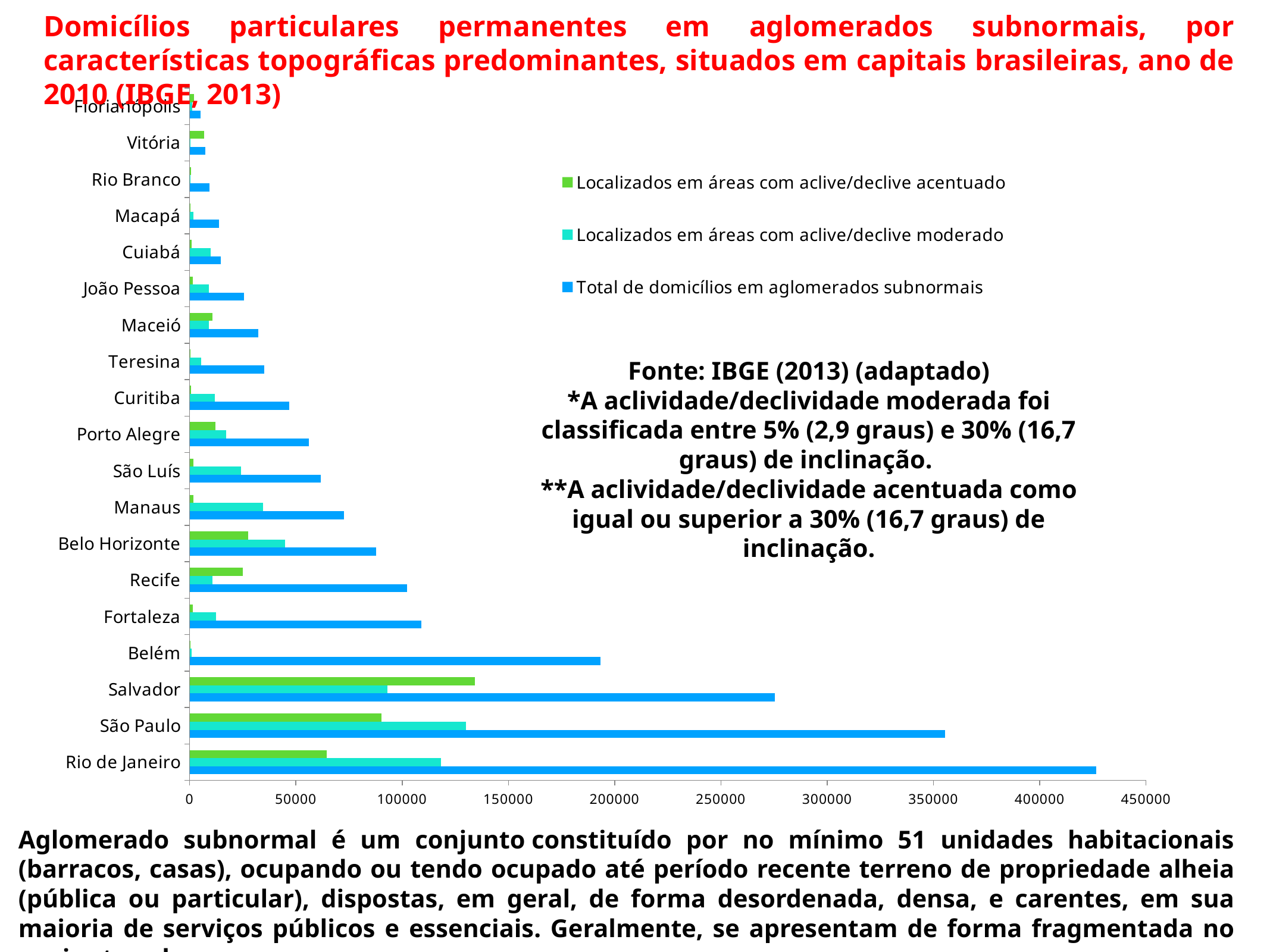
Is the value for Salvador in 'Total de domicílios em aglomerados subnormais' greater or less than 300000? less Which is larger: the 'Localizados em áreas com aclive/declive moderado' value for São Paulo or for Salvador? São Paulo Which capital has the highest value for 'Total de domicílios em aglomerados subnormais'? Rio de Janeiro Is the value for Belém in 'Total de domicílios em aglomerados subnormais' greater or less than 200000? less How many capitals (categories) are plotted on the chart? 19 Is the value for Salvador in 'Localizados em áreas com aclive/declive acentuado' greater or less than 100000? greater Which capital has the highest value for 'Localizados em áreas com aclive/declive acentuado'? Salvador Which series is shown in green in the legend? Localizados em áreas com aclive/declive acentuado What kind of chart is shown on the slide? bar chart How many series does the legend list? 3